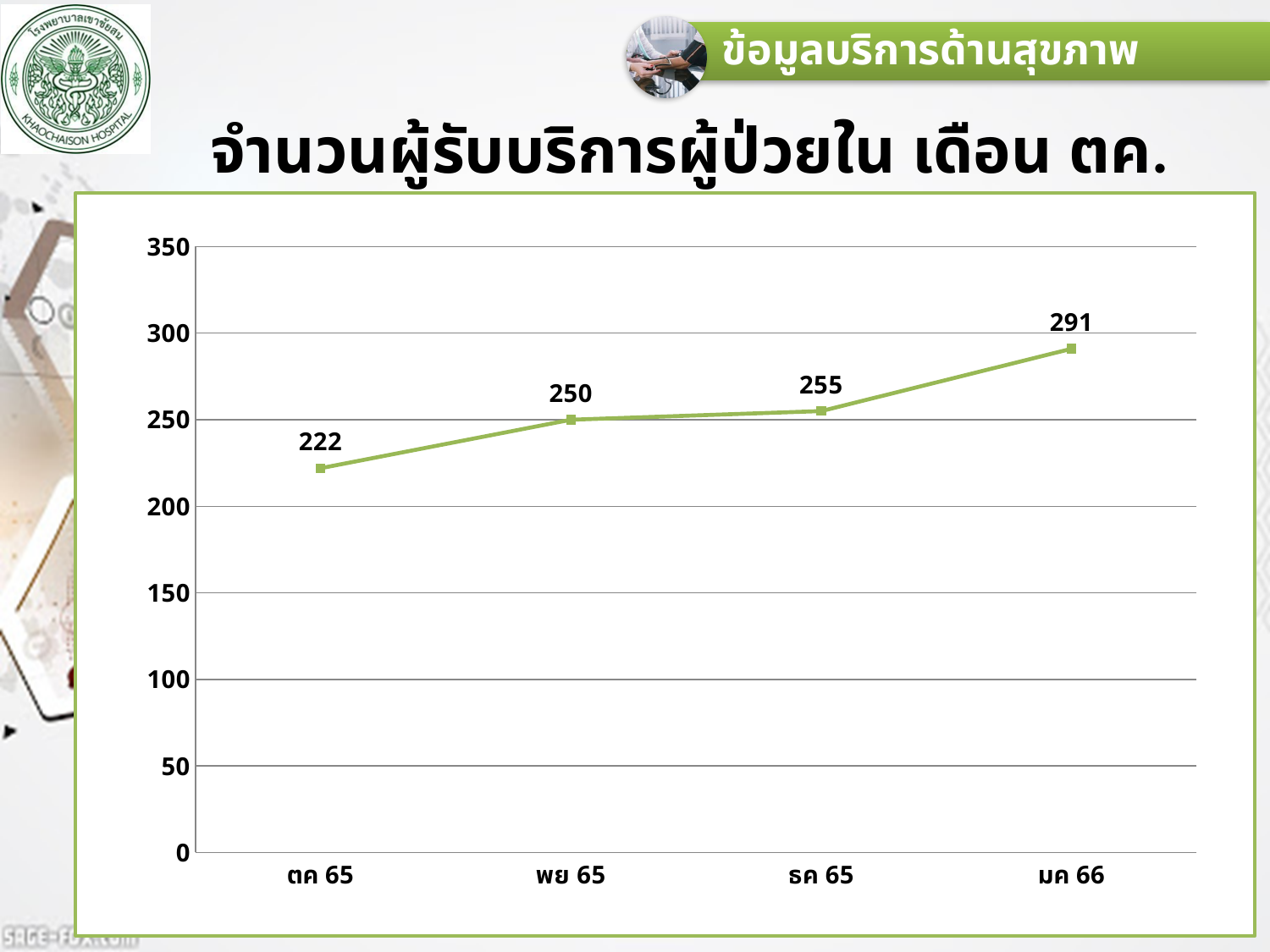
Which month has the lowest value? ตค 65 What kind of chart is shown on the slide? Line chart Which is larger, the value for พย 65 or the value for มค 66? มค 66 What is the difference between the values for มค 66 and ตค 65? 69 What is the value for ธค 65? 255 What is the value for ตค 65? 222 What is the difference between the values for ธค 65 and พย 65? 5 Which month has the highest value? มค 66 What is the value for มค 66? 291 What is the value for พย 65? 250 Do the values rise or fall from ตค 65 to มค 66? Rise How many data points are plotted on the chart? 4